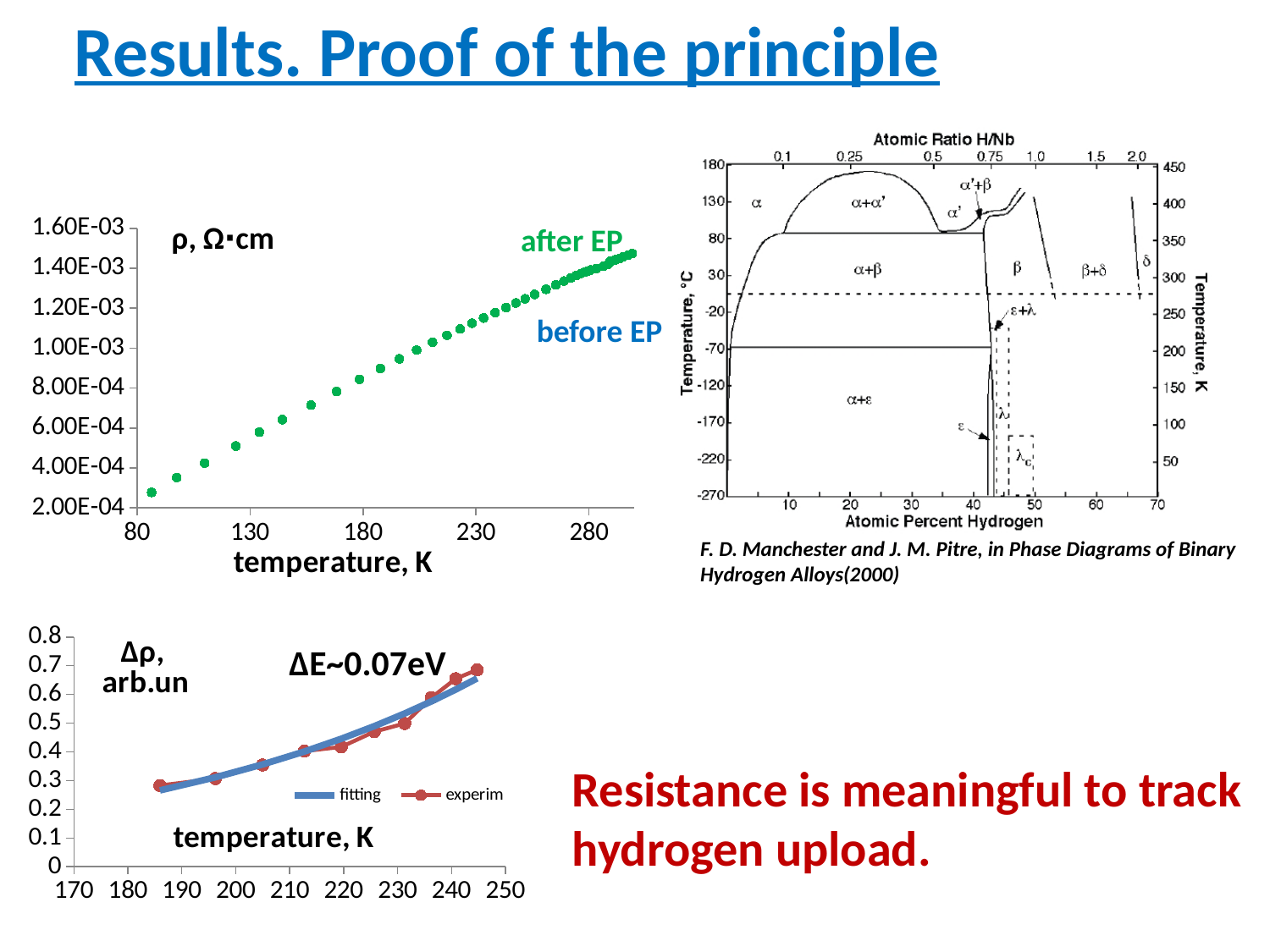
In the bottom-left chart, does Δρ rise or fall as temperature increases? rise In the bottom-left chart, is the experim value at the lowest temperature greater or less than 0.4? less In the top-left chart, does ρ rise or fall as temperature increases? rise In the top-left chart, is the lowest plotted value of ρ greater or less than 4.00E-04? less In the bottom-left chart, is the experim value at 245 K greater or less than 0.6? greater How many series does the legend of the bottom-left chart list? 2 What unit is given for ρ in the top-left chart? Ω·cm What is the x-axis label of the top-left chart? temperature, K What kind of chart is the top-left chart of ρ versus temperature? scatter chart What kind of chart is the bottom-left chart of Δρ versus temperature? line chart